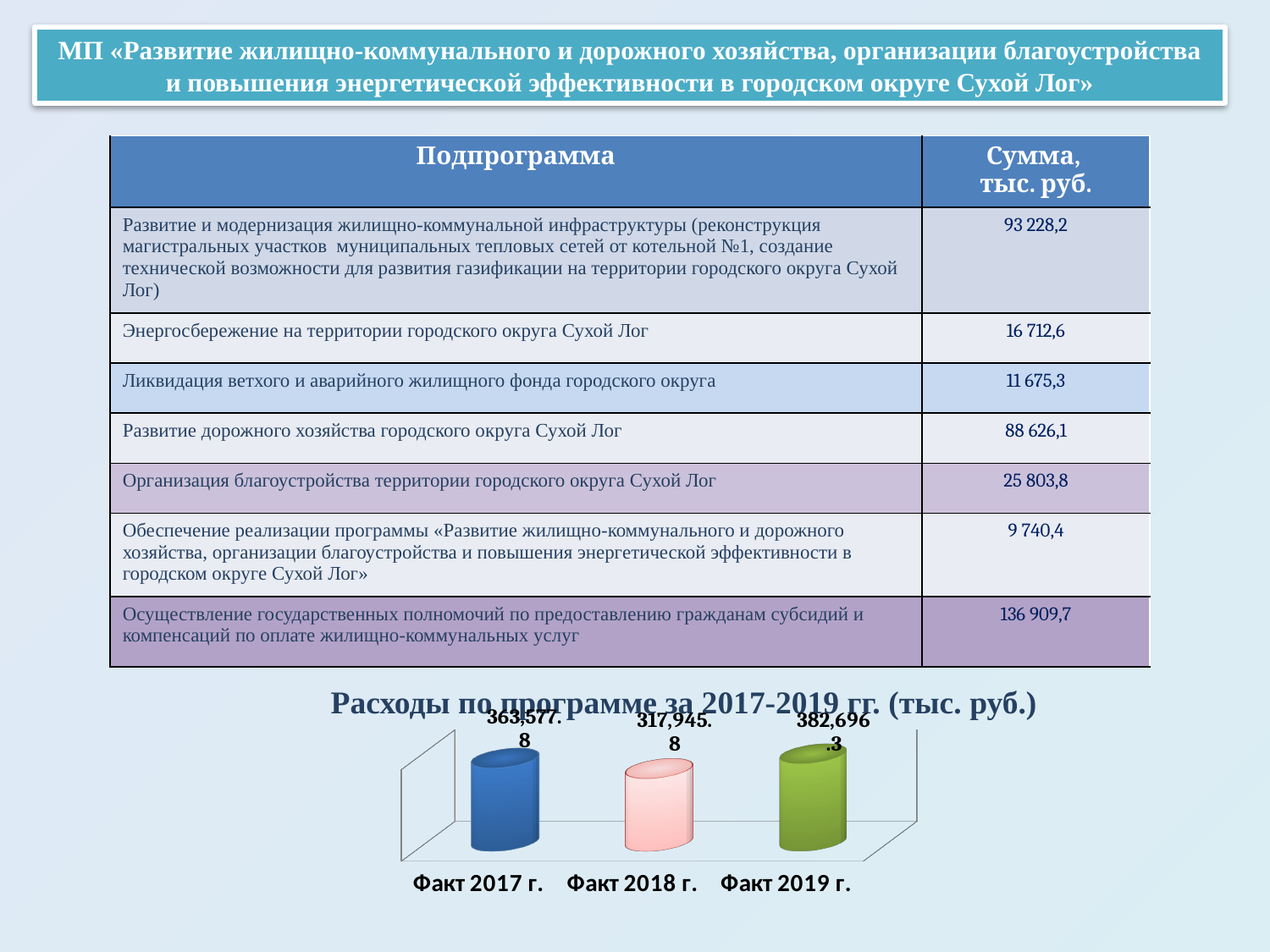
Which is larger, the value for Факт 2017 г. or Факт 2018 г.? Факт 2017 г. What is the title of the chart? Расходы по программе за 2017-2019 гг. (тыс. руб.) How many categories are shown in the chart? 3 What is the difference between the values for Факт 2019 г. and Факт 2017 г.? 19,118.5 What kind of chart is shown on the slide? bar chart Does the value rise or fall from Факт 2017 г. to Факт 2018 г.? fall What is the value for Факт 2018 г. in the chart? 317,945.8 Which category has the highest value in the chart? Факт 2019 г. What is the difference between the values for Факт 2017 г. and Факт 2018 г.? 45,632.0 Which category has the lowest value in the chart? Факт 2018 г. What is the value for Факт 2019 г. in the chart? 382,696.3 What is the value for Факт 2017 г. in the chart? 363,577.8